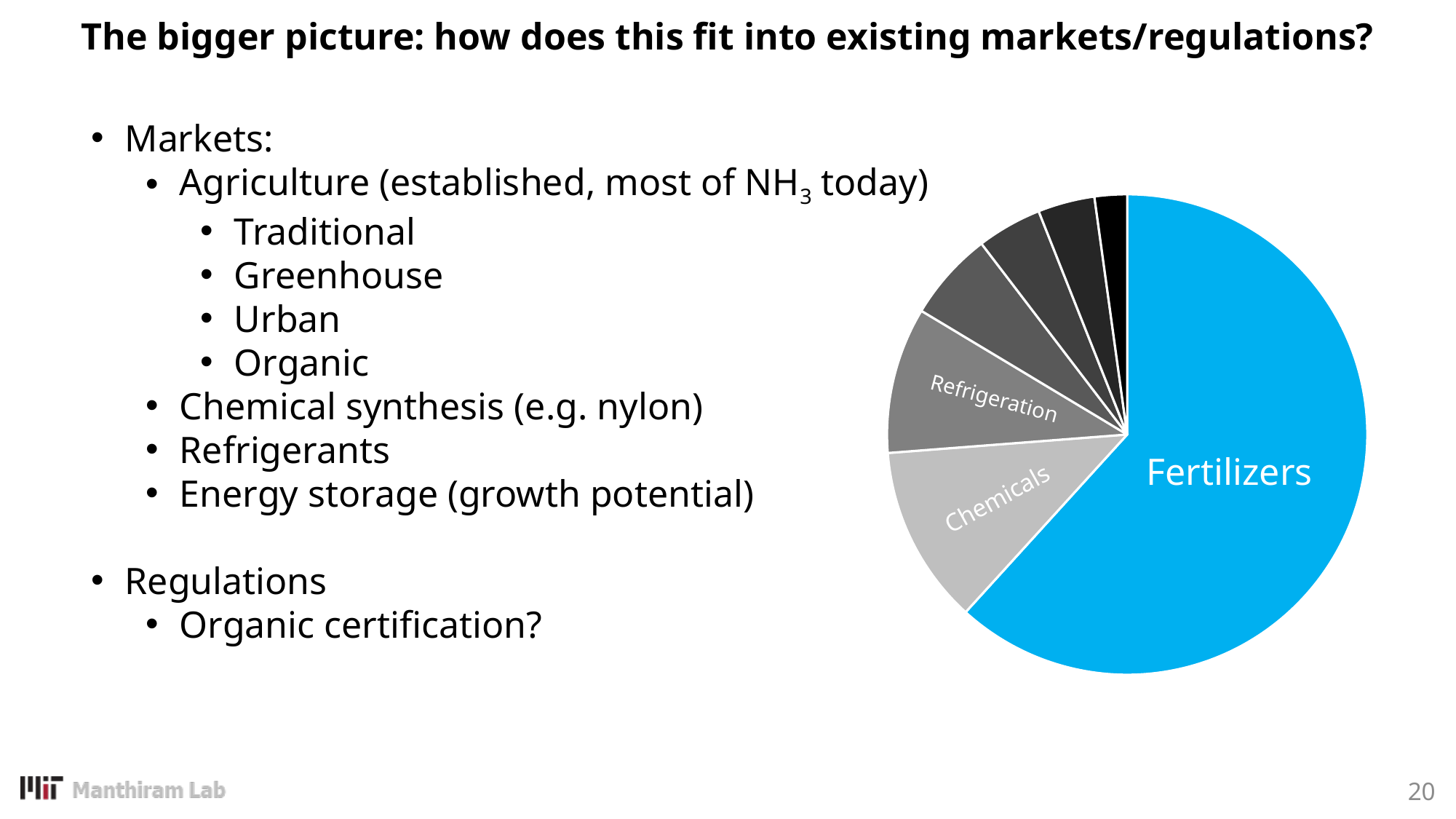
How many slices does the pie chart have in total? 7 Which slice of the pie chart is the largest? Fertilizers Of the labeled slices in the pie chart, which is the smallest? Refrigeration How many slices of the pie chart have a text label? 3 Which three slices of the pie chart are labeled? Fertilizers, Chemicals, Refrigeration Which slice is larger in the pie chart, Fertilizers or Chemicals? Fertilizers Which slice is larger in the pie chart, Chemicals or Refrigeration? Chemicals What colour is the Fertilizers slice in the pie chart? blue What kind of chart is shown on the slide? pie chart Does the Fertilizers slice take up more or less than half of the pie chart? more